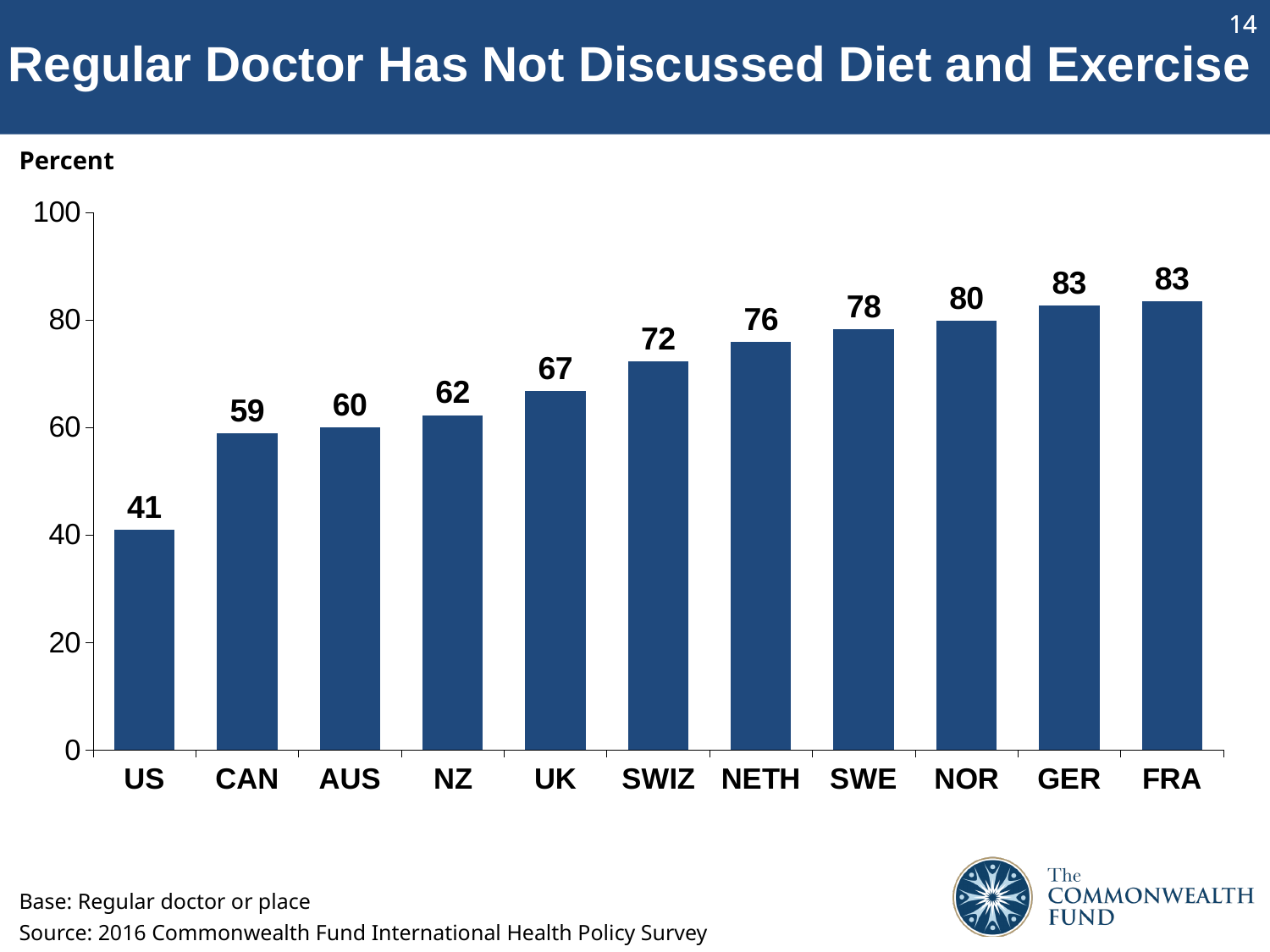
Do the values rise or fall from left to right along the x axis? rise What is the value for NOR? 80 What kind of chart is shown on the slide? bar chart What is the value for the US? 41 Is the value for SWE greater or less than 60? greater Which country has the lowest value? US What is the title of the chart? Regular Doctor Has Not Discussed Diet and Exercise What is the difference between the values for FRA and US? 42 What is the value for SWIZ? 72 How many countries are shown on the chart? 11 Which is larger, the value for UK or the value for AUS? UK What is the difference between the values for NETH and CAN? 17